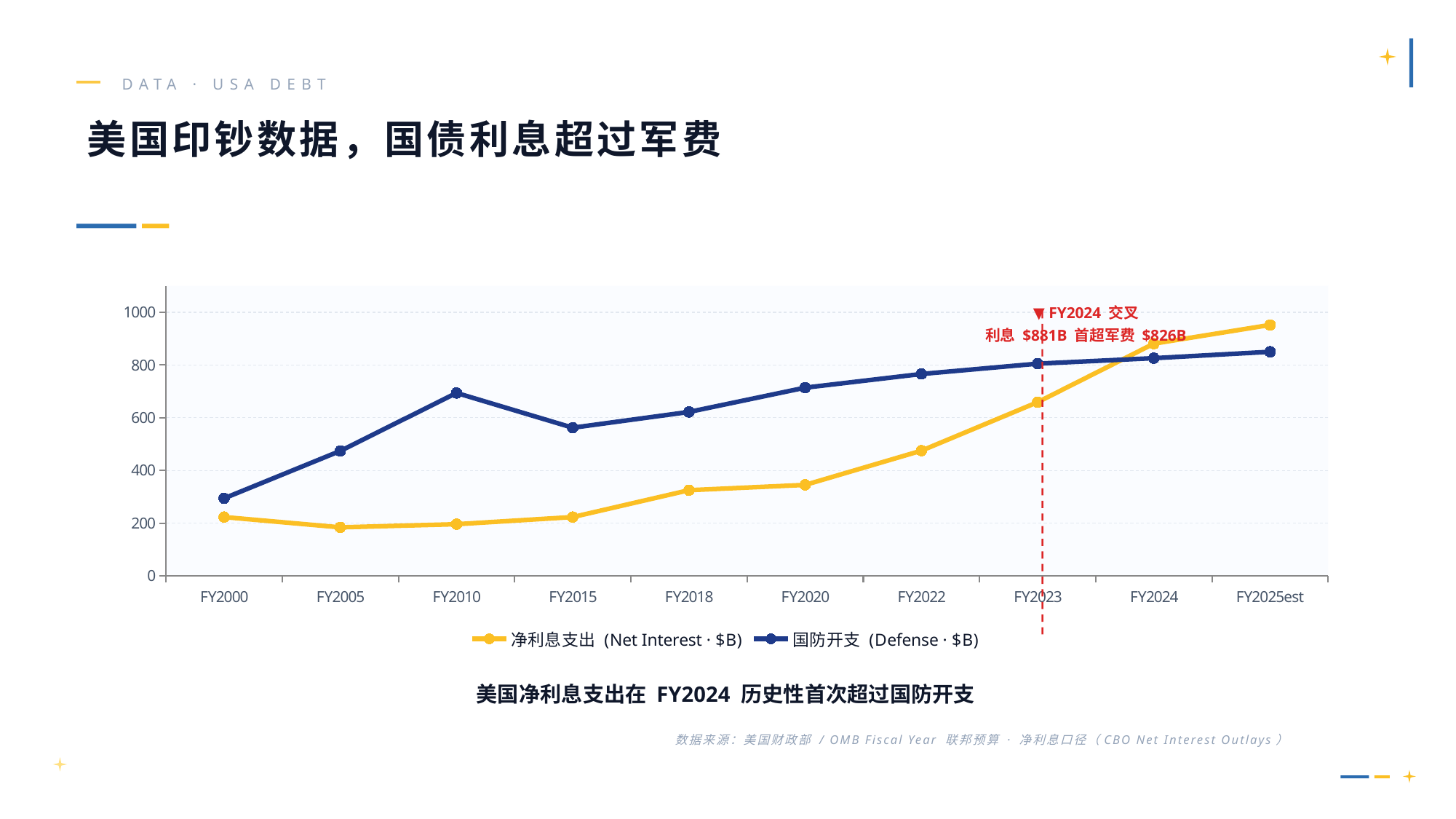
According to the annotation, what was net interest spending in FY2024? $881B In which fiscal year is the defense series at its lowest? FY2000 In FY2025est, which series has the larger value, net interest or defense? Net interest How many fiscal-year categories are shown on the x axis? 10 Is the defense value for FY2010 greater or less than 600? greater In FY2010, which series has the larger value, net interest or defense? Defense According to the annotation, what was defense spending in FY2024? $826B Is the net interest value for FY2000 greater or less than 400? less Does the net interest series generally rise or fall from FY2000 to FY2025est? Rise How many series does the chart legend list? 2 What type of chart is shown on the slide? Line chart By how much did net interest exceed defense spending in FY2024, based on the annotated values? $55B